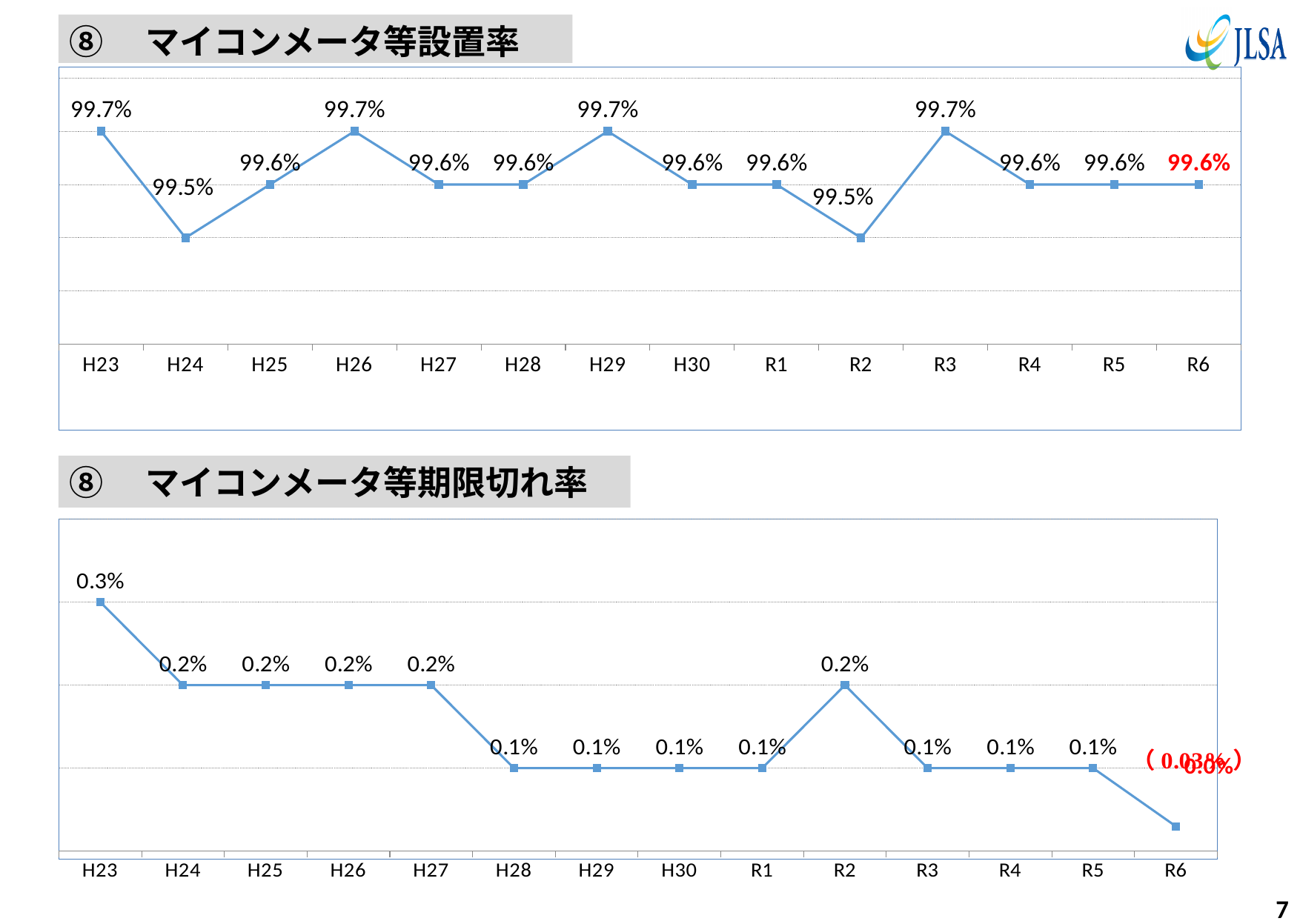
In the マイコンメータ等設置率 chart, what is the difference between the values for H26 and R2? 0.2% What kind of chart is the マイコンメータ等設置率 chart? line chart In the マイコンメータ等期限切れ率 chart, what is the difference between the values for H23 and H28? 0.2% In the マイコンメータ等設置率 chart, what is the value for H24? 99.5% In the マイコンメータ等設置率 chart, how many categories are shown on the x axis? 14 In the マイコンメータ等期限切れ率 chart, what is the value for H23? 0.3% In the マイコンメータ等期限切れ率 chart, what is the value for R2? 0.2% In the マイコンメータ等期限切れ率 chart, do the values generally rise or fall from H23 to R6? fall In the マイコンメータ等設置率 chart, which is larger, the value for H23 or the value for H24? H23 In the マイコンメータ等設置率 chart, what is the value for R6? 99.6% In the マイコンメータ等期限切れ率 chart, which category has the highest value? H23 In the マイコンメータ等設置率 chart, what is the value for R3? 99.7%